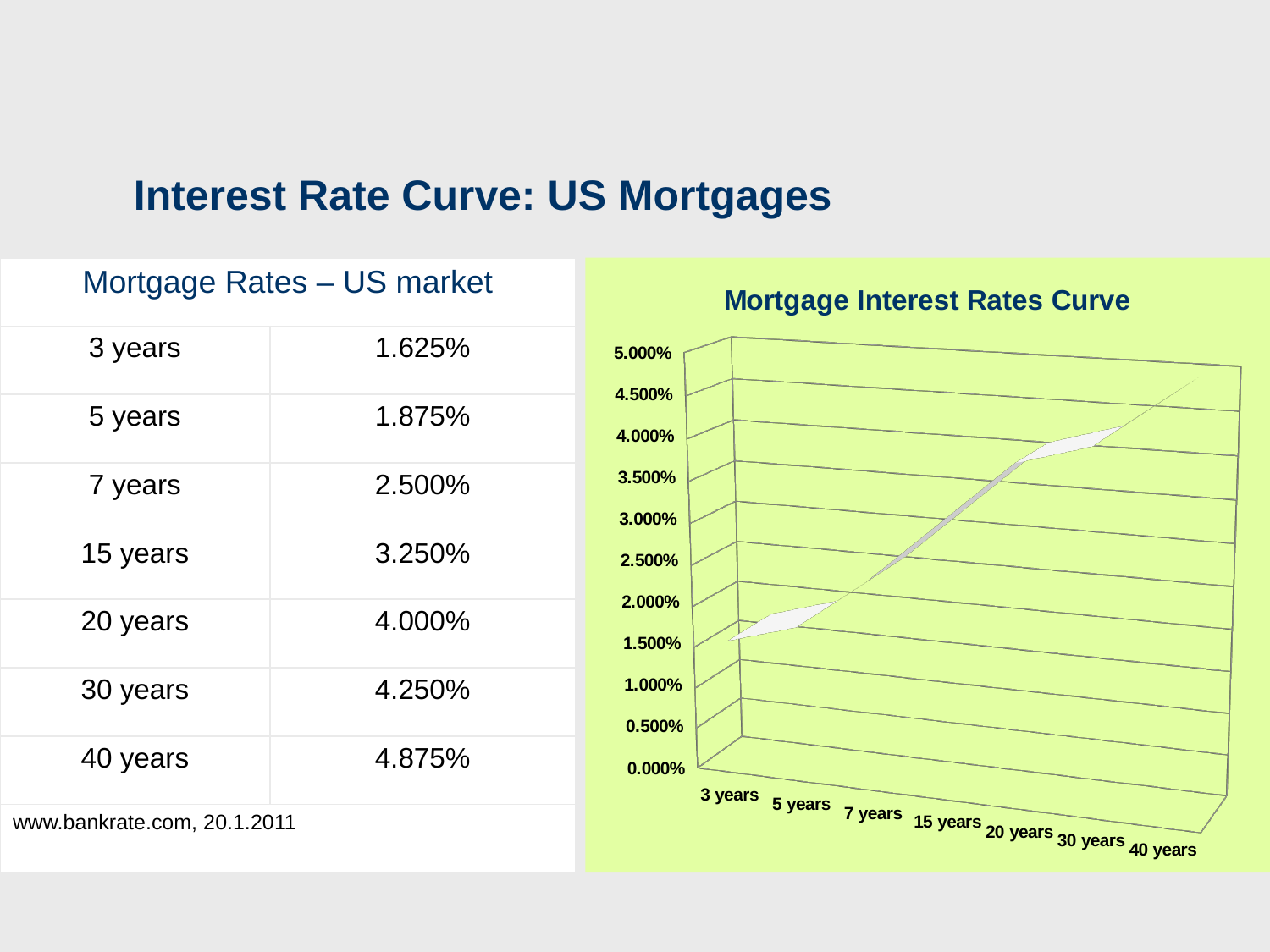
What is the difference between the mortgage rate for 40 years and for 3 years? 3.250% What is the mortgage rate for 20 years? 4.000% What is the title of the chart? Mortgage Interest Rates Curve Is the value for 15 years greater or less than 3.000%? greater Which has the higher mortgage rate, 7 years or 30 years? 30 years How many loan terms are plotted along the x axis of the chart? 7 Which loan term has the highest mortgage rate? 40 years What type of chart is shown on the slide? line chart Do the mortgage rates rise or fall as the loan term increases along the x axis? rise Is the value for 3 years greater or less than 2.000%? less Is the value for 40 years greater or less than 4.500%? greater Which loan term has the lowest mortgage rate? 3 years